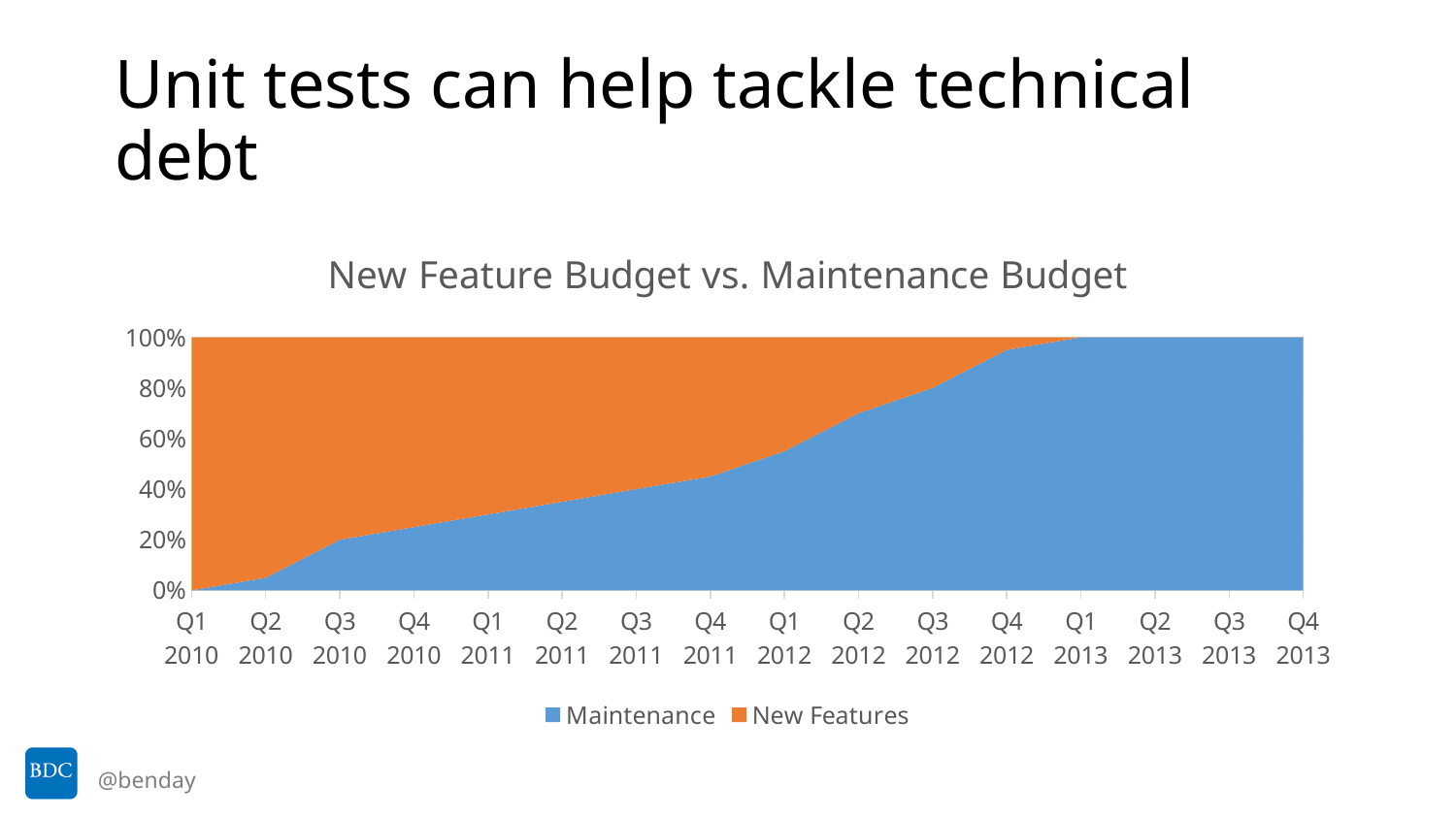
What is the Maintenance share in Q4 2013? 100% Is the Maintenance share in Q4 2012 greater or less than 80%? greater Is the Maintenance share in Q2 2012 greater or less than 60%? greater Does the New Features share rise or fall from Q1 2010 to Q4 2013? Fall In Q1 2010, which series has the larger share, Maintenance or New Features? New Features How many series does the legend list? 2 What kind of chart is shown on the slide? Area chart What is the title of the chart? New Feature Budget vs. Maintenance Budget How many quarters are shown along the x axis? 16 Is the Maintenance share in Q2 2010 greater or less than 20%? less Does the Maintenance share rise or fall from Q1 2010 to Q4 2013? Rise Which series is shown in blue? Maintenance